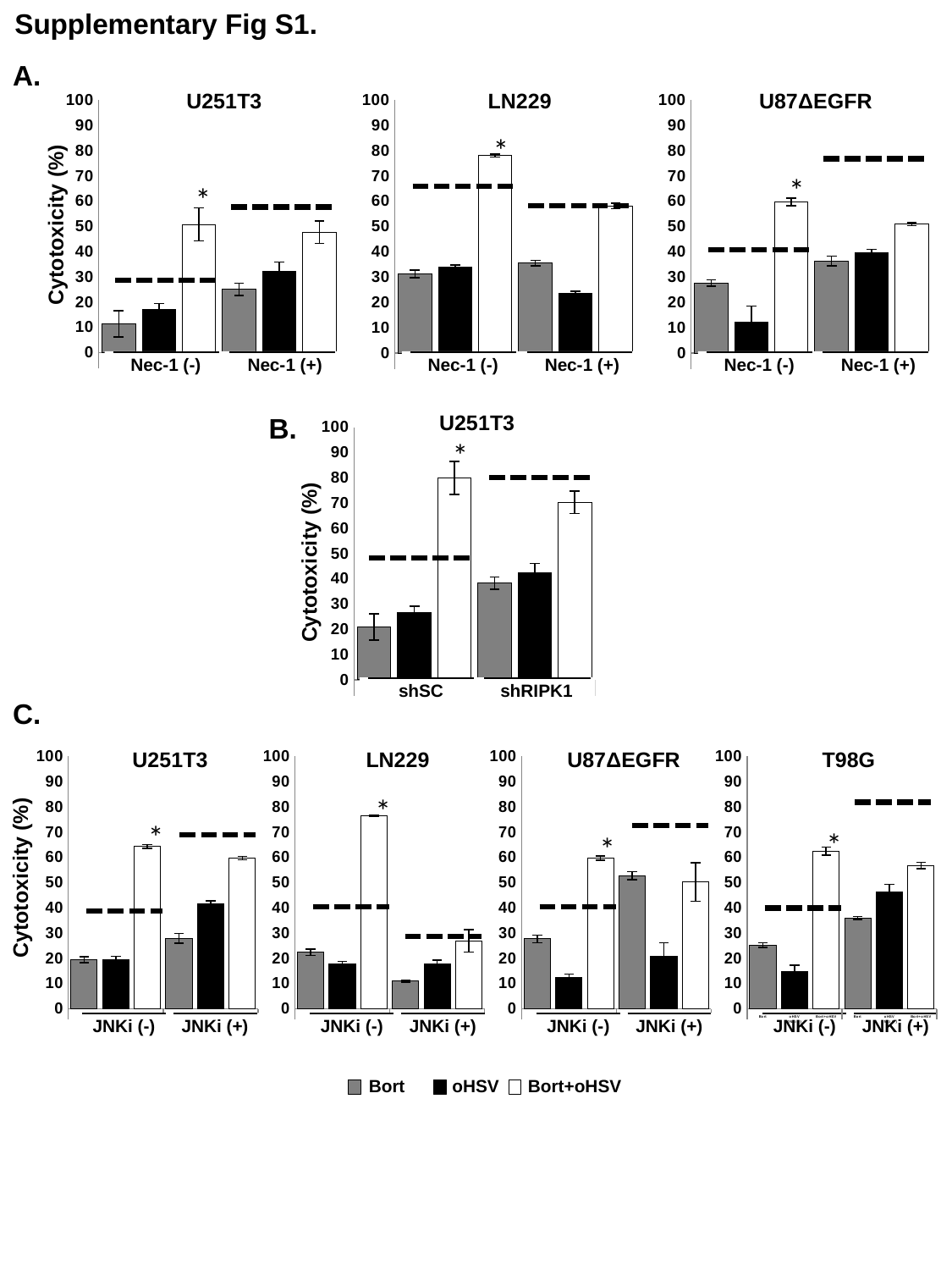
In the LN229 chart in panel C, is the Bort value under JNKi (+) greater or less than 20? less What is the y-axis label on the charts in panel A? Cytotoxicity (%) In the U251T3 chart in panel A, is the Bort value under Nec-1 (-) greater or less than 20? less In the U251T3 chart in panel B, which bar is the highest? Bort+oHSV under shSC In the U87ΔEGFR chart in panel A, under Nec-1 (-), which is larger: Bort or oHSV? Bort In the LN229 chart in panel A, is the Bort+oHSV value under Nec-1 (-) greater or less than 70? greater What kind of chart is the U251T3 chart in panel B? Bar chart In the U87ΔEGFR chart in panel C, under JNKi (+), which is larger: Bort or oHSV? Bort How many series does the legend at the bottom of the slide list? 3 In the LN229 chart in panel C, which bar is the lowest? Bort under JNKi (+) How many charts are shown in panel C? 4